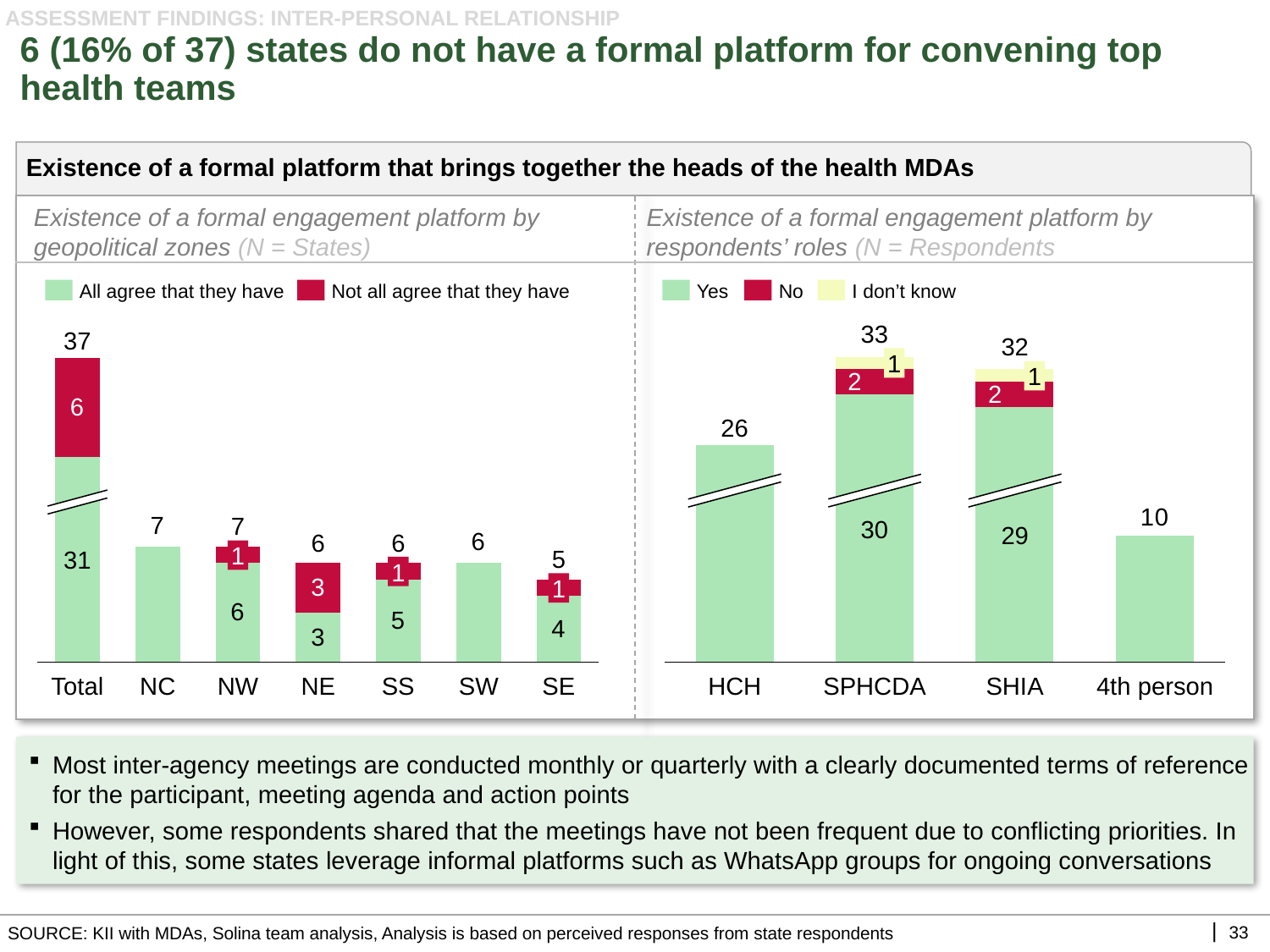
In the right chart (by respondents' roles), which role has the highest total number of respondents? SPHCDA In the left chart (by geopolitical zones), what is the difference between the 'All agree' and 'Not all agree' segments for NE? 0 In the left chart (by geopolitical zones), how many zone categories are shown on the x axis, including Total? 7 In the left chart (by geopolitical zones), how many states in the Total bar fall under 'Not all agree that they have'? 6 In the right chart (by respondents' roles), is the total for HCH larger or smaller than the total for 4th person? larger In the left chart (by geopolitical zones), how many states in NW are in the 'All agree that they have' segment? 6 What type of chart is used in the right chart (by respondents' roles)? Stacked bar chart In the right chart (by respondents' roles), what is the total number of SHIA respondents? 32 In the left chart (by geopolitical zones), which zone (excluding Total) has the lowest total number of states? SE In the left chart (by geopolitical zones), how many series does the legend list? 2 In the right chart (by respondents' roles), how many SPHCDA respondents answered 'Yes'? 30 In the left chart (by geopolitical zones), what is the total number of states for NE? 6